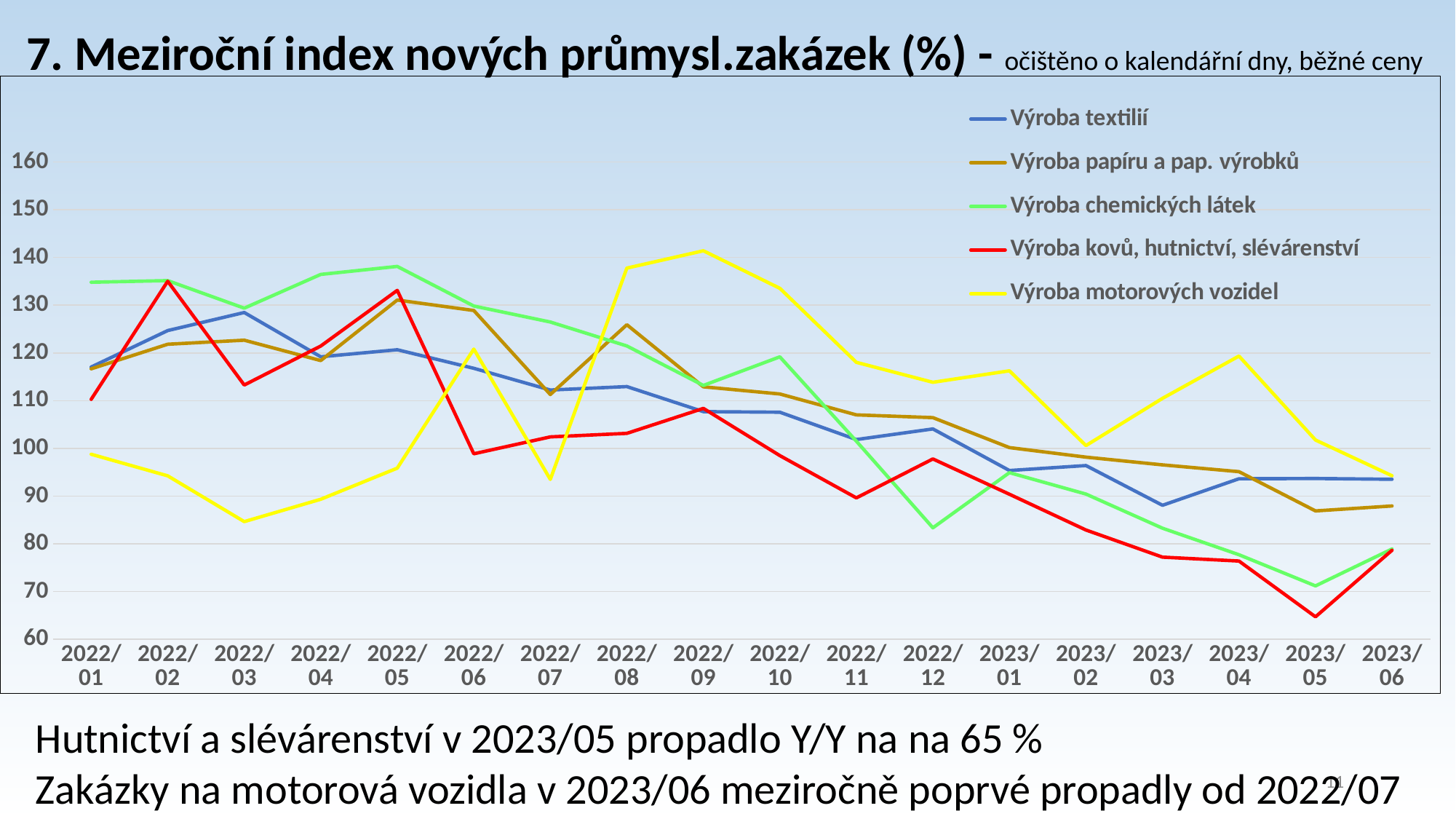
Is the value for Výroba motorových vozidel in 2022/03 greater or less than 90? less Is the value for Výroba kovů, hutnictví, slévárenství in 2023/05 greater or less than 70? less Is the value for Výroba motorových vozidel in 2022/09 greater or less than 130? greater Which series has the lowest value in 2022/01? Výroba motorových vozidel Which series has the highest value in 2022/09? Výroba motorových vozidel Which colour is used for the Výroba kovů, hutnictví, slévárenství series? red What kind of chart is shown on the slide? line chart How many time points are shown on the x axis? 18 In 2022/02, which is higher: Výroba kovů, hutnictví, slévárenství or Výroba textilií? Výroba kovů, hutnictví, slévárenství Does the Výroba chemických látek series rise or fall from 2022/05 to 2023/05? fall How many series does the legend list? 5